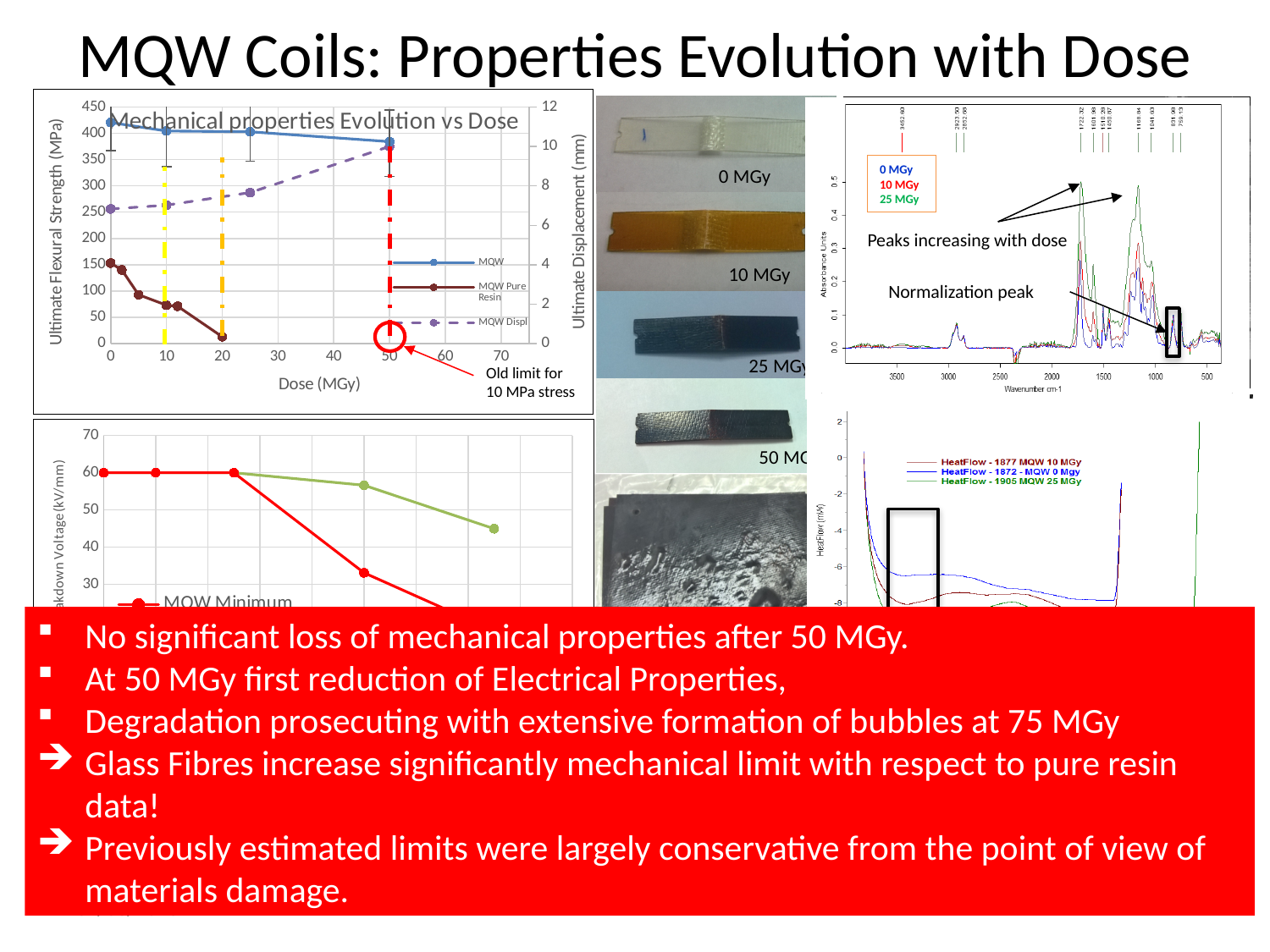
In the 'Mechanical properties Evolution vs Dose' chart, how many series does the legend list? 3 In the 'Mechanical properties Evolution vs Dose' chart, does the MQW Displ series rise or fall as dose increases? rise In the bottom-left breakdown voltage chart, what is the breakdown voltage of the first MQW Minimum point? 60 In the 'Mechanical properties Evolution vs Dose' chart, is the MQW ultimate flexural strength at 50 MGy greater or less than 350 MPa? greater What kind of chart is the 'Mechanical properties Evolution vs Dose' chart? line chart In the 'Mechanical properties Evolution vs Dose' chart, is the MQW ultimate flexural strength at 50 MGy greater or less than 400 MPa? less In the 'Mechanical properties Evolution vs Dose' chart, which has the higher ultimate flexural strength at 0 MGy, MQW or MQW Pure Resin? MQW In the 'Mechanical properties Evolution vs Dose' chart, is the MQW Displ value at 50 MGy greater or less than 8 mm? greater In the 'Mechanical properties Evolution vs Dose' chart, does the MQW Pure Resin series rise or fall as dose increases? fall In the 'Mechanical properties Evolution vs Dose' chart, what is the label of the x axis? Dose (MGy) In the absorbance spectrum chart on the right, how many dose levels does the legend list? 3